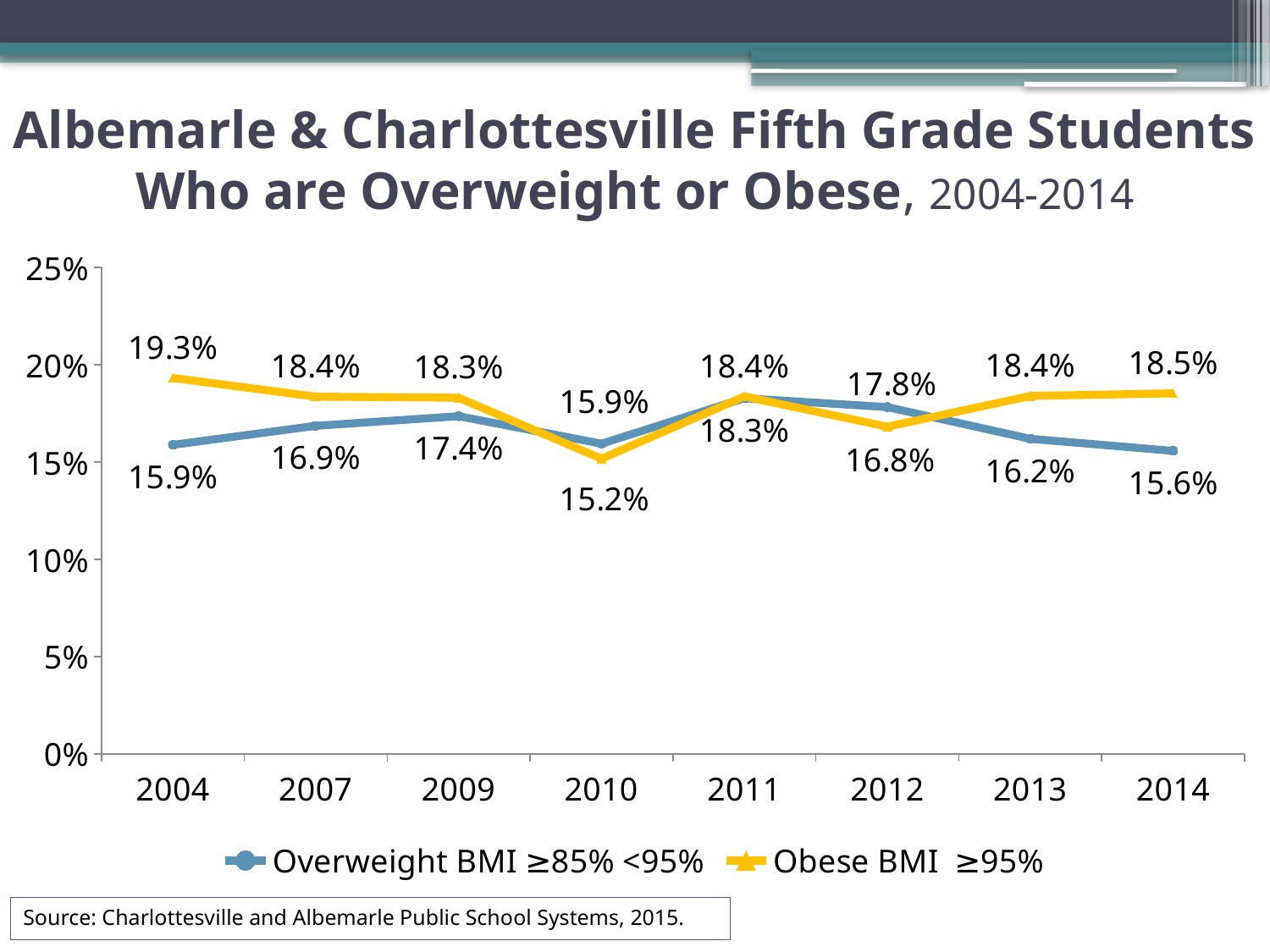
In 2014, which series has the higher value, Overweight or Obese? Obese BMI ≥95% What is the value for Obese BMI ≥95% in 2004? 19.3% What is the difference between the Obese and Overweight values in 2004? 3.4 percentage points What kind of chart is shown on the slide? Line chart In which year is the Overweight BMI ≥85% <95% value highest? 2011 In which year is the Obese BMI ≥95% value lowest? 2010 In which year is the Obese BMI ≥95% value highest? 2004 What is the value for Overweight BMI ≥85% <95% in 2014? 15.6% What is the value for Obese BMI ≥95% in 2010? 15.2% What is the source cited at the bottom of the slide? Charlottesville and Albemarle Public School Systems, 2015. How many series does the legend list? 2 How many years are plotted along the x axis? 8